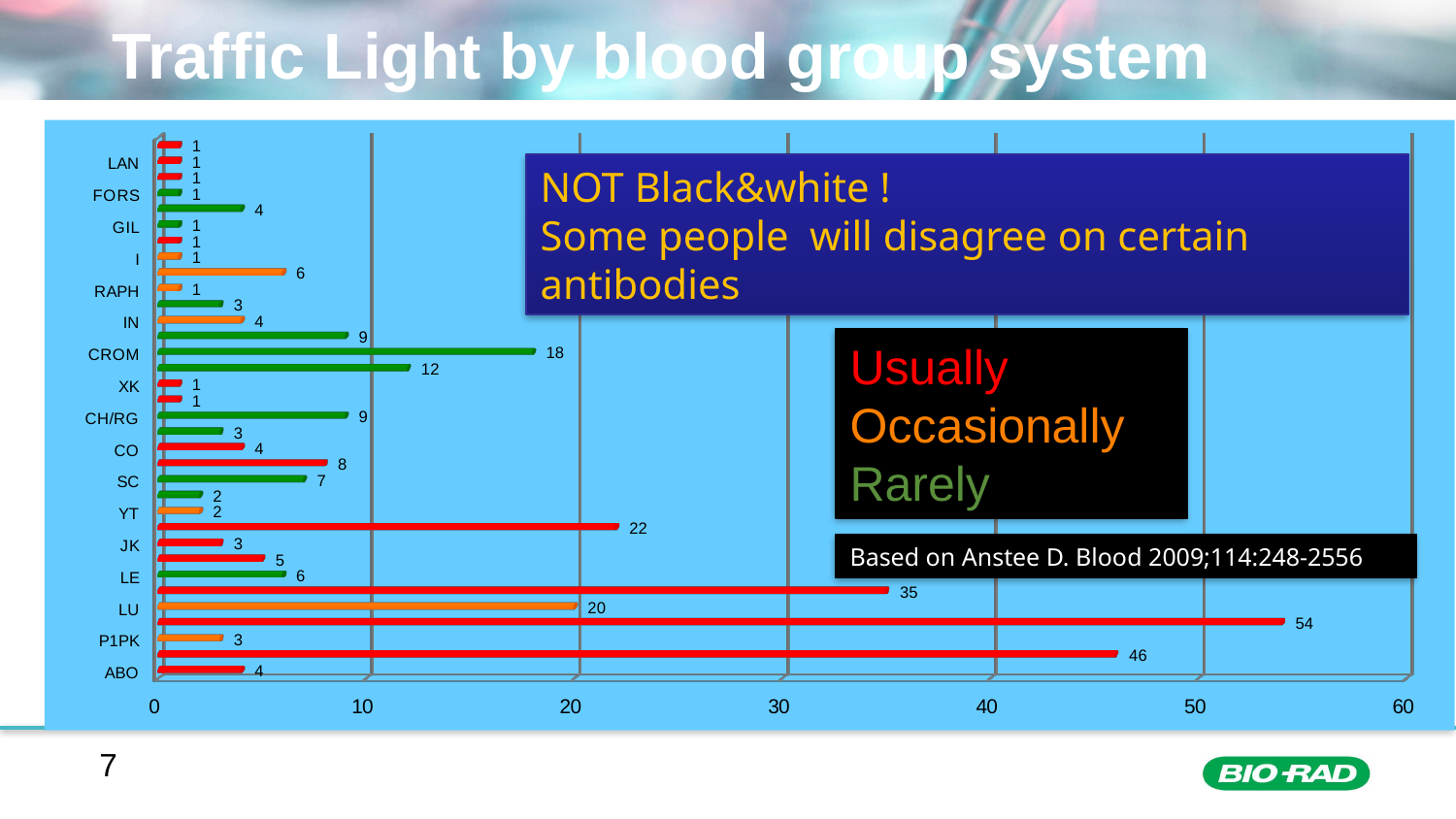
How many blood group system labels are shown on the vertical axis? 17 What is the highest value shown on the horizontal axis? 60 What is the difference between the values for LU and CROM? 2 What is the smallest value labelled on any bar in the chart? 1 Is the value for LU greater or less than 10? greater Which has the larger value, LU or CROM? LU What is the value of the bar for LU? 20 According to the traffic light key, what does the red colour mean? Usually What kind of chart is shown on the slide? bar chart What is the largest value labelled on any bar in the chart? 54 What is the value of the bar for CROM? 18 What is the value of the bar for CH/RG? 9